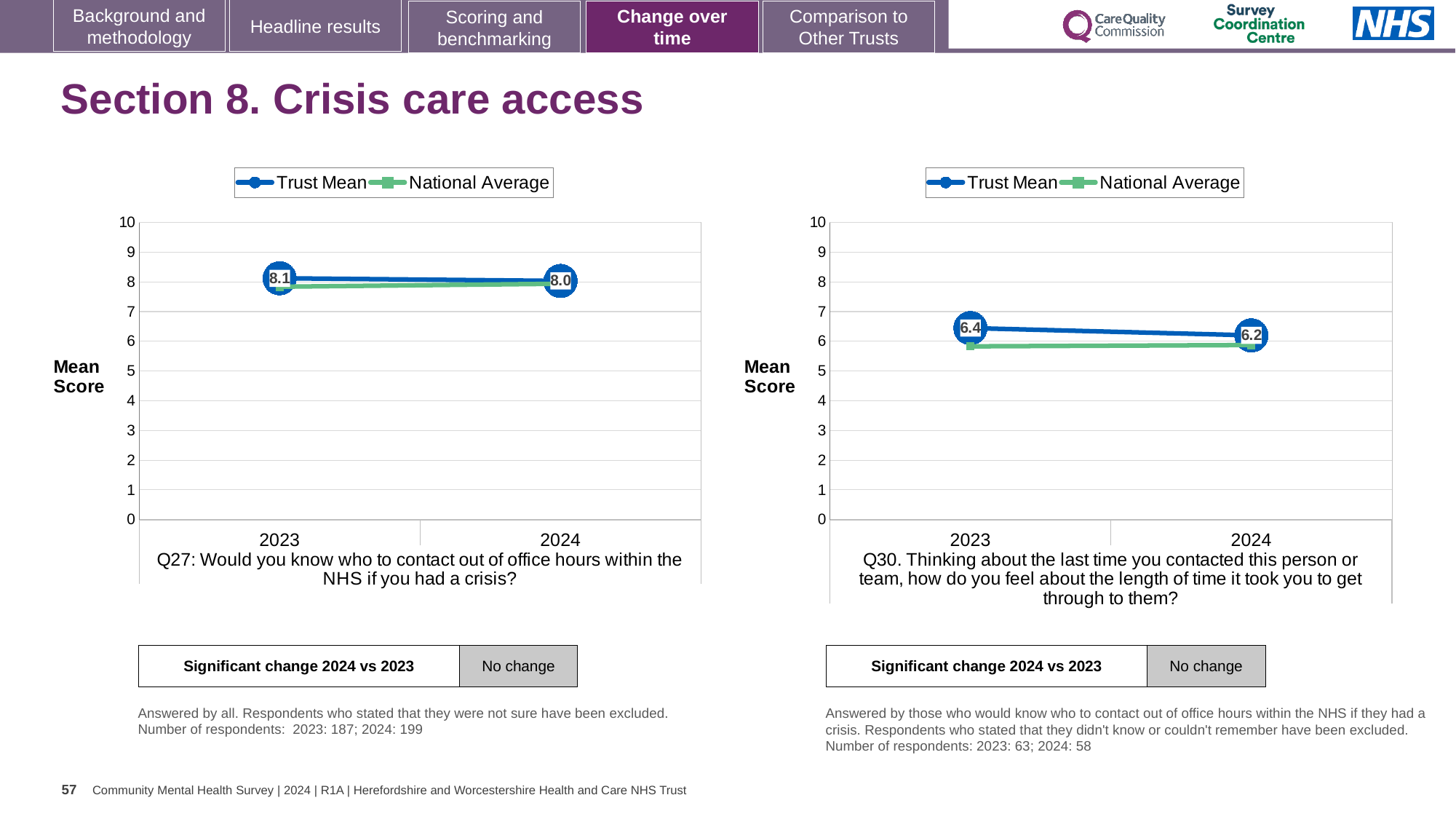
In the left chart (Q27), what is the Trust Mean score for 2023? 8.1 In the right chart (Q30), what is the Trust Mean score for 2023? 6.4 In the right chart (Q30), does the Trust Mean rise or fall from 2023 to 2024? fall In the right chart (Q30), which year has the higher Trust Mean score? 2023 In the right chart (Q30), what is the Trust Mean score for 2024? 6.2 What kind of chart is the left chart (Q27)? line chart In the left chart (Q27), what is the Trust Mean score for 2024? 8.0 In the right chart (Q30), is the Trust Mean or the National Average higher in 2023? Trust Mean In the right chart (Q30), is the National Average for 2023 greater or less than 5? greater In the left chart (Q27), what is the difference between the Trust Mean scores for 2023 and 2024? 0.1 In the right chart (Q30), by how much did the Trust Mean score change from 2023 to 2024? 0.2 How many series does the legend of the left chart (Q27) list? 2